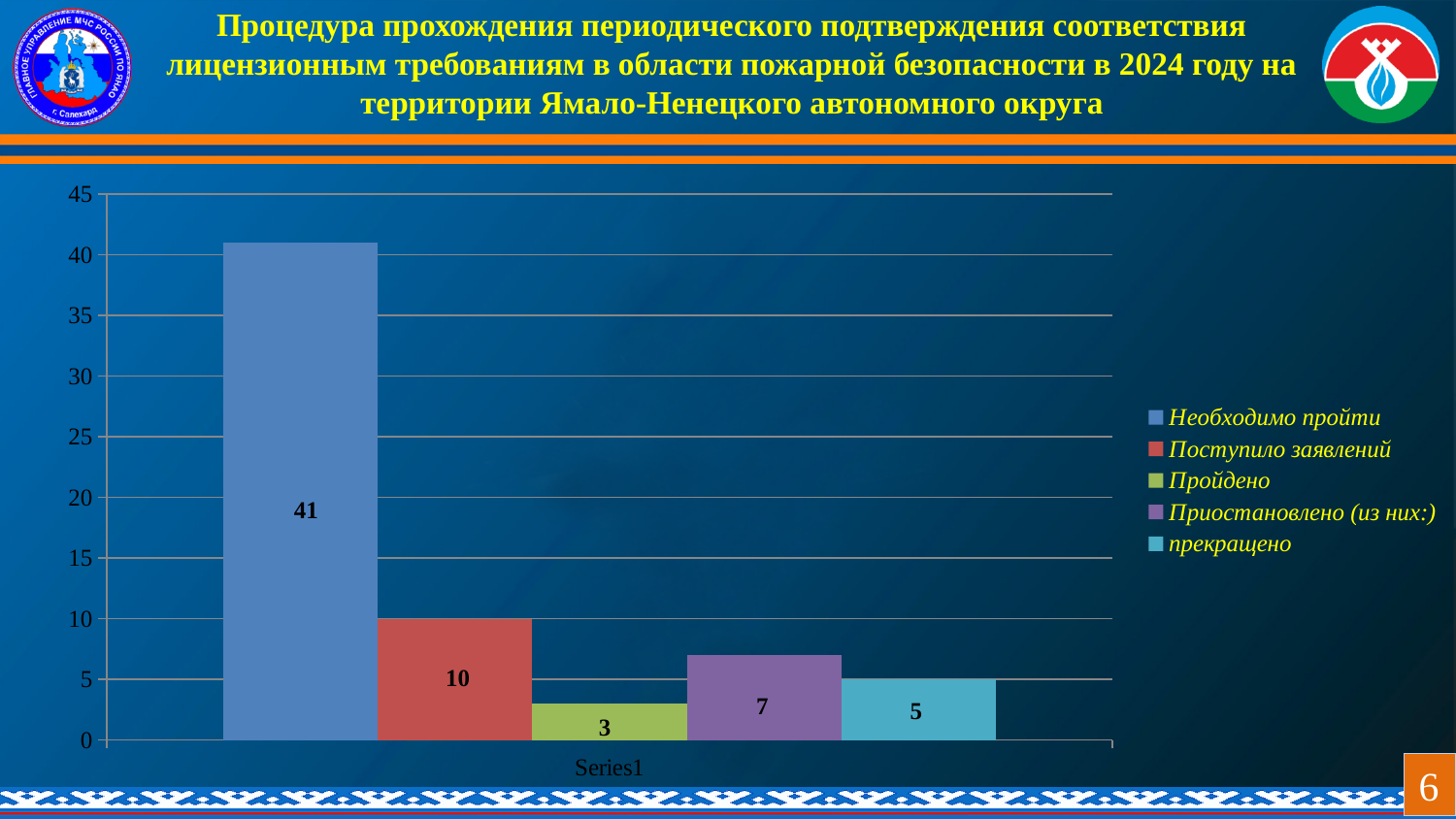
What is the value for "прекращено"? 5 Which series has the lowest value? Пройдено What is the value for "Поступило заявлений"? 10 Which series has the highest value? Необходимо пройти What is the value for "Пройдено"? 3 What is the difference between the values for "Необходимо пройти" and "Поступило заявлений"? 31 Is the value for "Необходимо пройти" greater or less than 40? greater Which is larger, the value for "Приостановлено (из них:)" or the value for "прекращено"? Приостановлено (из них:) What kind of chart is shown on the slide? bar chart What is the value for "Приостановлено (из них:)"? 7 How many series does the legend list? 5 What is the value for "Необходимо пройти"? 41